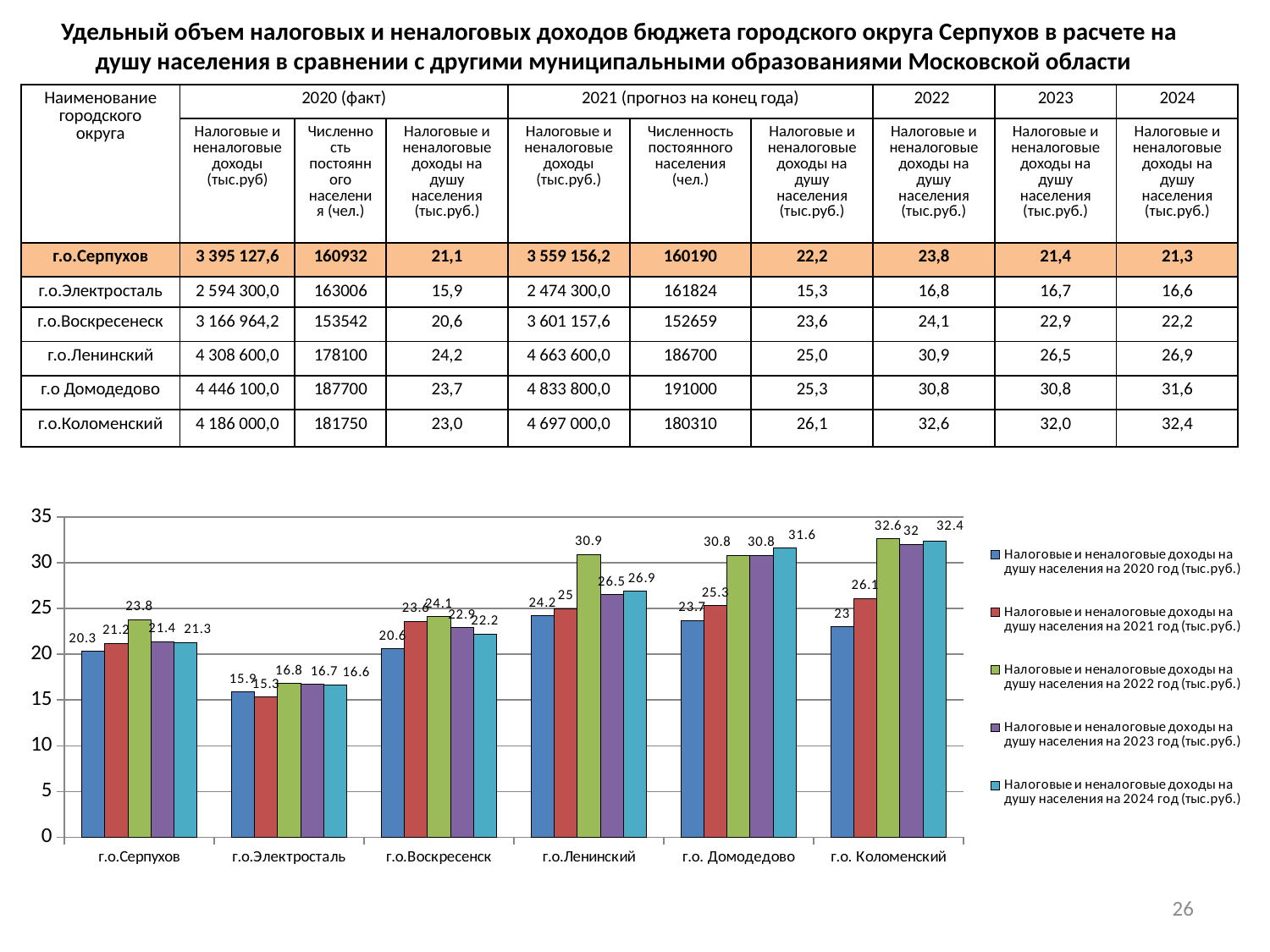
How many series does the chart legend list? 5 Which municipality has the highest value for 2022 in the chart? г.о. Коломенский In the chart, which is larger for 2023: the value for г.о.Ленинский or the value for г.о. Домодедово? г.о. Домодедово In the chart, what is the per-capita revenue value for г.о. Коломенский in 2024? 32.4 How many municipalities (categories) are shown on the x axis of the chart? 6 In the chart, what is the per-capita revenue value for г.о.Ленинский in 2022? 30.9 In the chart, by how much does the 2024 value for г.о. Домодедово exceed its 2020 value? 7.9 In the chart, what is the per-capita revenue value for г.о.Электросталь in 2021? 15.3 Is the 2023 value for г.о. Коломенский in the chart greater or less than 30? greater What kind of chart is shown on the slide? bar chart Which year does the green series in the chart legend represent? 2022 Which municipality has the lowest value for 2020 in the chart? г.о.Электросталь